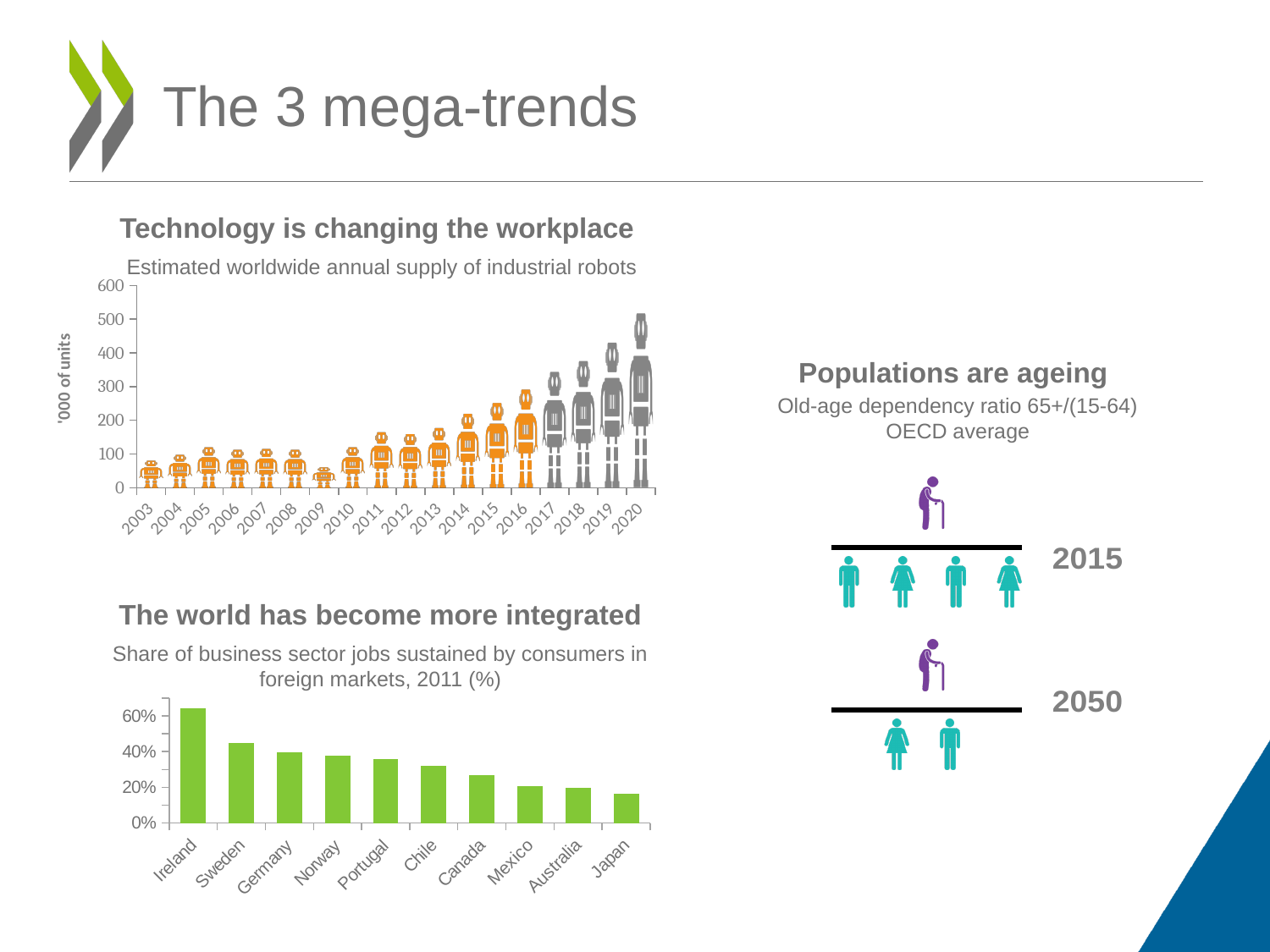
In the chart 'Estimated worldwide annual supply of industrial robots', which year has the lowest value? 2009 What is the y-axis unit label on the chart 'Estimated worldwide annual supply of industrial robots'? '000 of units In the chart 'Share of business sector jobs sustained by consumers in foreign markets, 2011 (%)', which is larger, the value for Chile or the value for Mexico? Chile In the chart 'Estimated worldwide annual supply of industrial robots', do the values generally rise or fall from 2010 to 2020? rise How many countries are shown in the chart 'Share of business sector jobs sustained by consumers in foreign markets, 2011 (%)'? 10 In the chart 'Estimated worldwide annual supply of industrial robots', which year has the highest value? 2020 In the chart 'Share of business sector jobs sustained by consumers in foreign markets, 2011 (%)', which country has the highest share? Ireland In the chart 'Estimated worldwide annual supply of industrial robots', is the value for 2020 greater or less than 400? greater In the chart 'Share of business sector jobs sustained by consumers in foreign markets, 2011 (%)', is the value for Ireland greater or less than 60%? greater In the chart 'Share of business sector jobs sustained by consumers in foreign markets, 2011 (%)', which country has the lowest share? Japan In the chart 'Estimated worldwide annual supply of industrial robots', is the value for 2009 greater or less than 100? less How many years are shown on the x axis of the chart 'Estimated worldwide annual supply of industrial robots'? 18